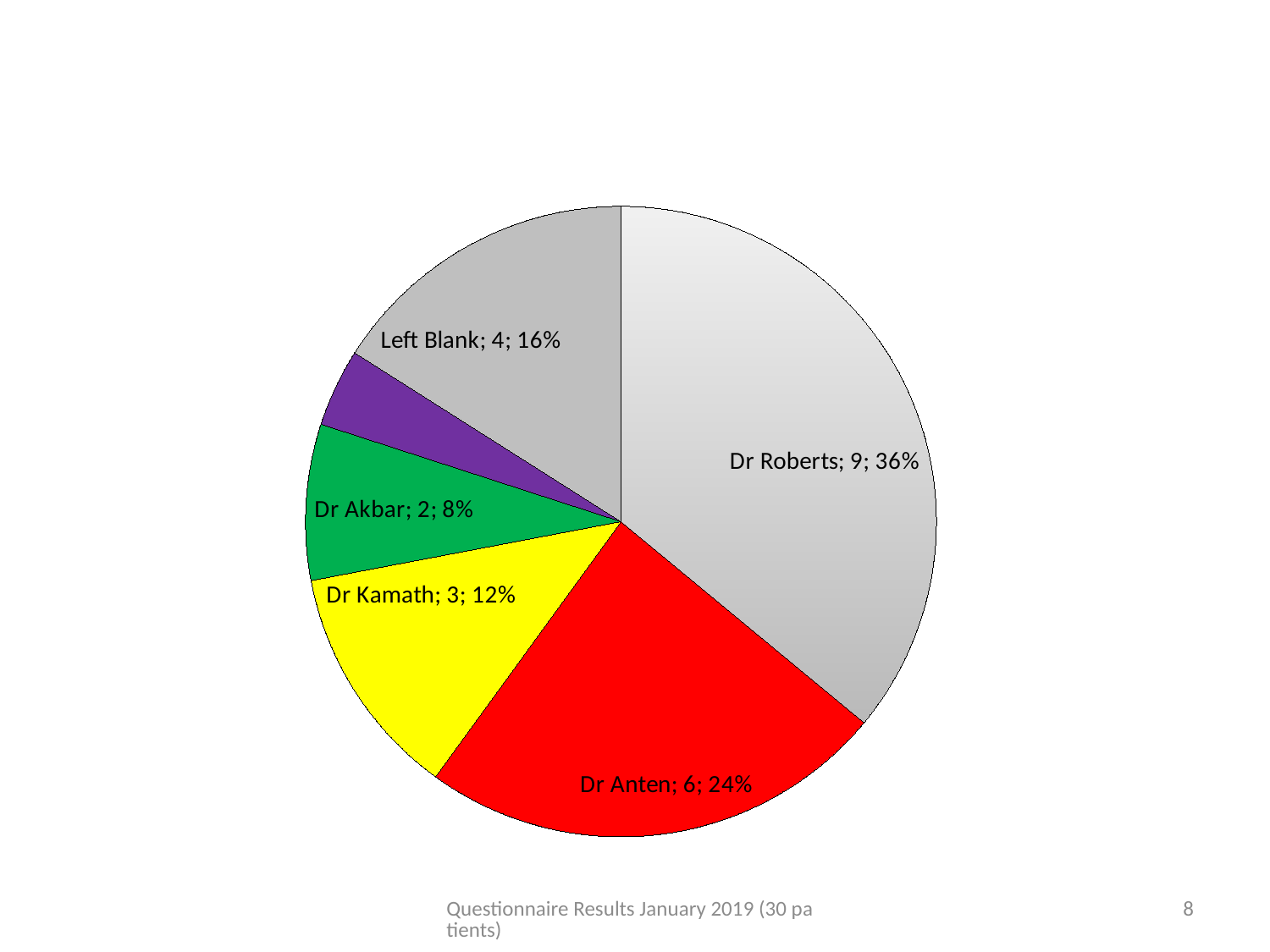
What percentage of the pie does Dr Anten's slice represent? 24% What is the value shown for Left Blank? 4 Which labelled slice has the smallest value? Dr Akbar Which is larger, the value for Left Blank or the value for Dr Kamath? Left Blank How many patients chose Dr Roberts? 9 How many slices does the pie chart have? 6 What is the difference between the values for Dr Roberts and Dr Anten? 3 What kind of chart is shown on the slide? pie chart What colour is the slice for Dr Anten? red What percentage is shown for Dr Akbar? 8% Which labelled slice has the largest value? Dr Roberts What is the value shown for Dr Kamath? 3